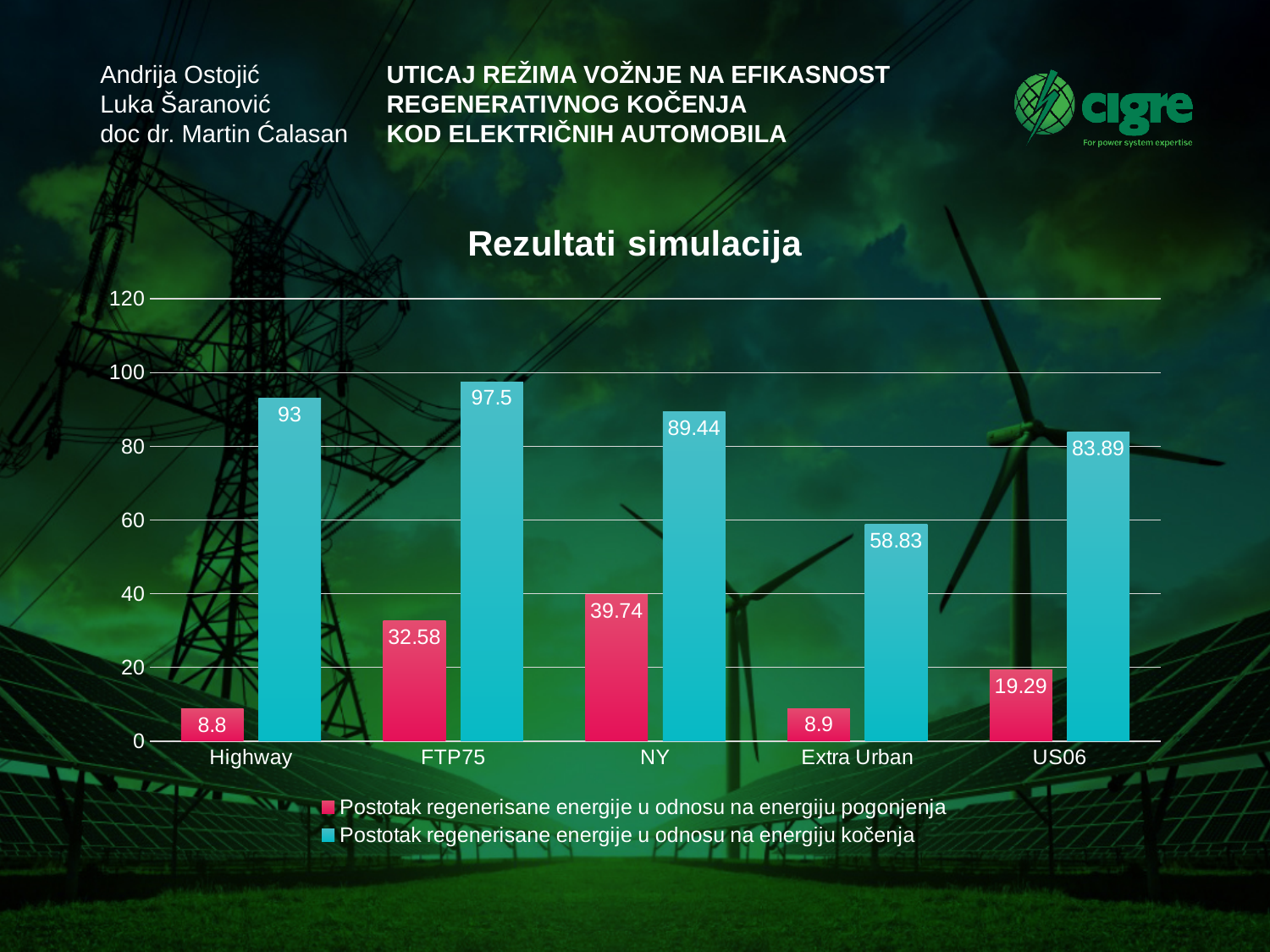
How many categories are shown on the x axis? 5 How many series does the legend list? 2 What type of chart is shown on the slide? bar chart What is the value of 'Postotak regenerisane energije u odnosu na energiju kočenja' for FTP75? 97.5 Is the 'energiju kočenja' value for Extra Urban greater or less than 60? less What is the value of 'Postotak regenerisane energije u odnosu na energiju pogonjenja' for US06? 19.29 Which category has the lowest value for 'Postotak regenerisane energije u odnosu na energiju kočenja'? Extra Urban Which category has the highest value for 'Postotak regenerisane energije u odnosu na energiju pogonjenja'? NY Which is larger: the 'energiju kočenja' value for Highway or for US06? Highway What is the value of 'Postotak regenerisane energije u odnosu na energiju pogonjenja' for NY? 39.74 What is the value of 'Postotak regenerisane energije u odnosu na energiju kočenja' for Extra Urban? 58.83 What is the difference between the two series' values for NY? 49.7